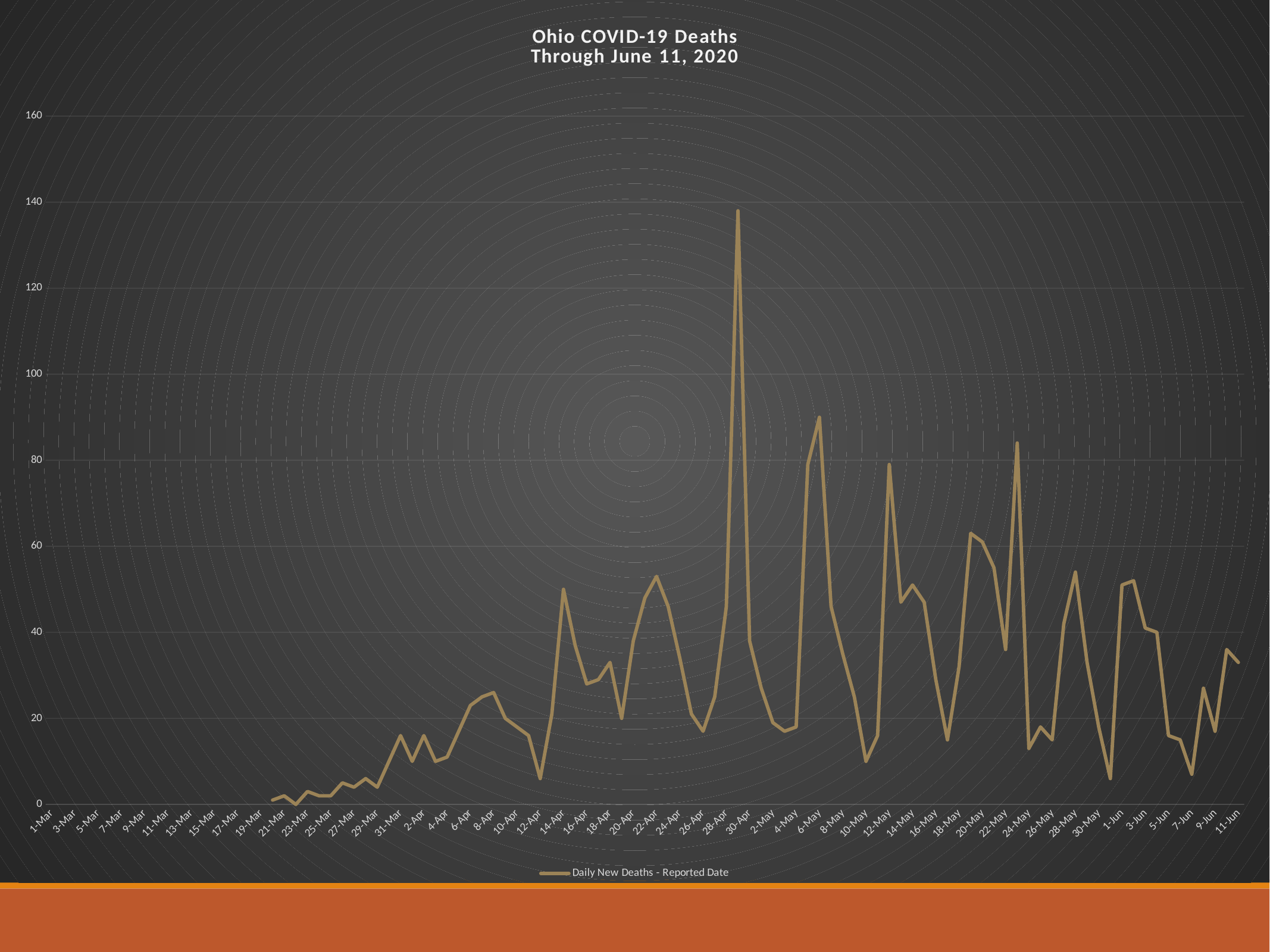
What is the name of the series shown in the legend? Daily New Deaths - Reported Date Is the value for 6-May greater or less than 80? greater What kind of chart is shown on the slide? line chart Is the value for 22-Apr greater or less than 40? greater How many series does the legend list? 1 Is the value for 31-Mar greater or less than 20? less What is the title of the chart? Ohio COVID-19 Deaths Through June 11, 2020 Do the values generally rise or fall from 21-Mar to 8-Apr? rise Do the values rise or fall from 29-Apr to 3-May? fall Which date has a larger value, 6-May or 10-May? 6-May